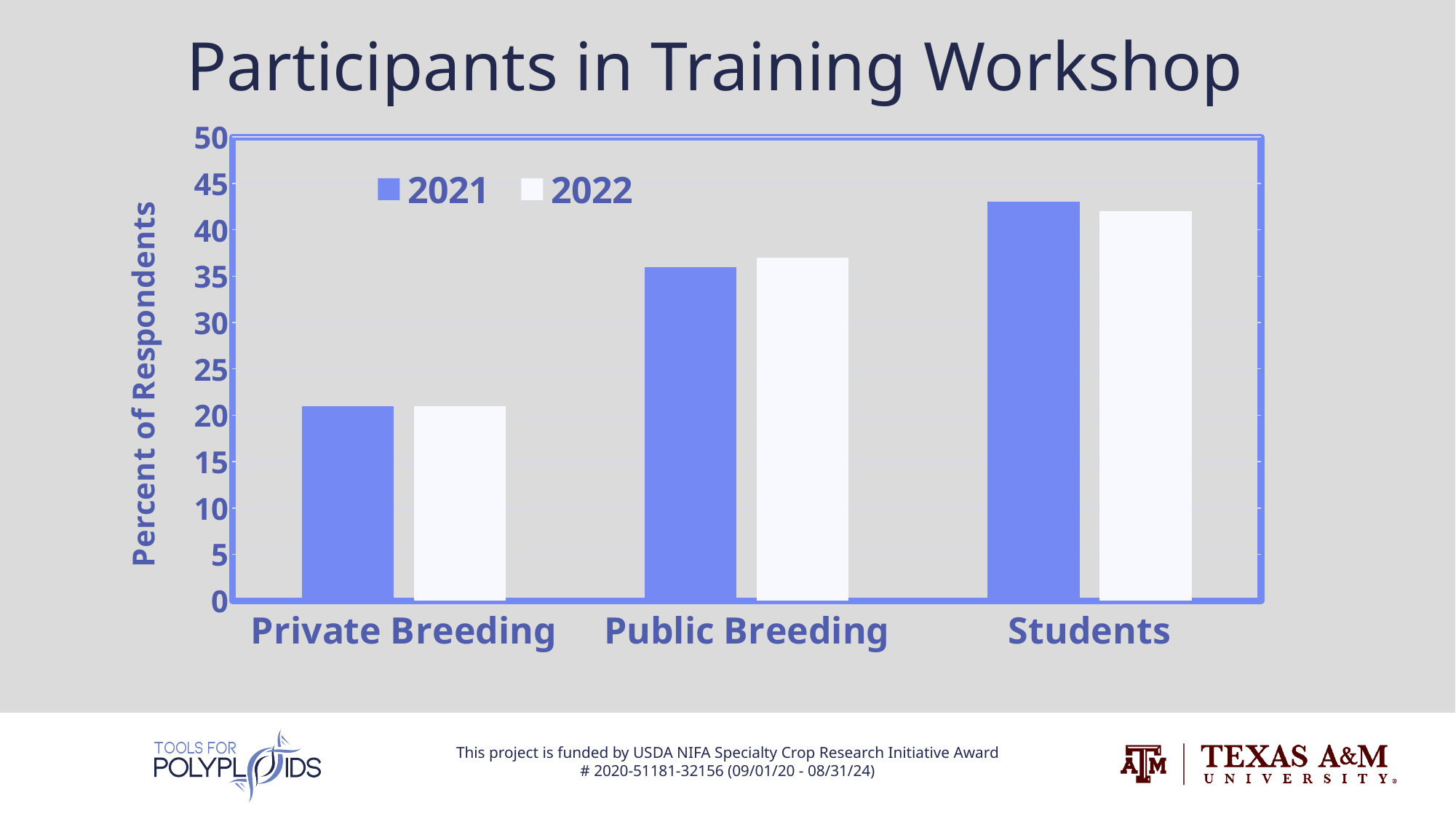
How many categories are shown on the x axis? 3 What kind of chart is shown on the slide? bar chart Is the 2021 value for Private Breeding greater or less than 25? less Is the 2021 value for Students greater or less than 40? greater For 2022, which is larger: Public Breeding or Private Breeding? Public Breeding Is the 2021 value for Public Breeding greater or less than 40? less Which category has the lowest value for 2022? Private Breeding Which category has the highest value for 2021? Students Do the 2021 values rise or fall moving from Private Breeding to Students along the x axis? rise What is the label on the y axis? Percent of Respondents How many series does the legend list? 2